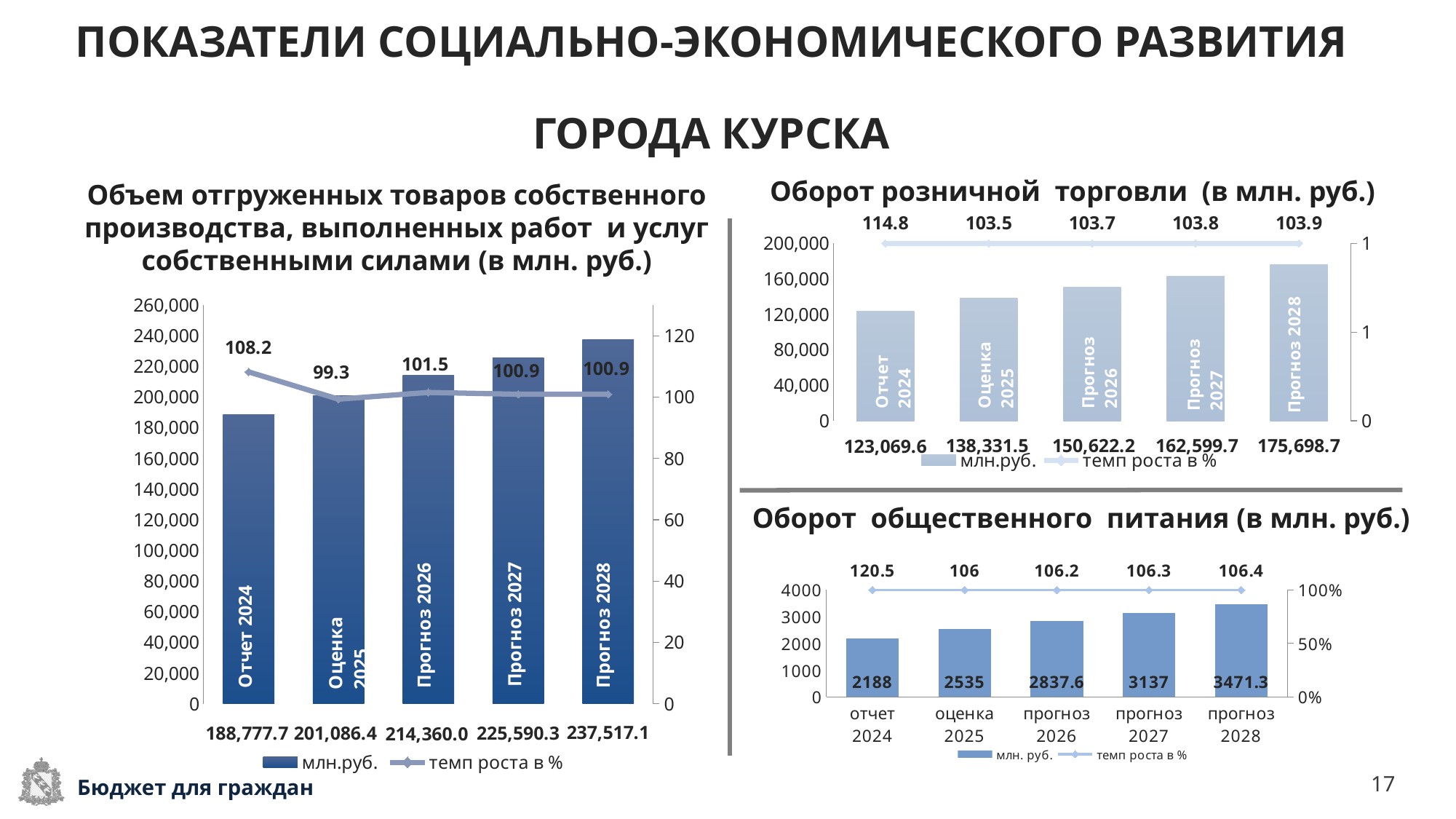
On the chart 'Оборот розничной торговли (в млн. руб.)', which period has the lowest growth rate (темп роста в %)? Оценка 2025 On the chart 'Оборот общественного питания (в млн. руб.)', do the bar values rise or fall from 'отчет 2024' to 'прогноз 2028'? rise On the chart 'Оборот розничной торговли (в млн. руб.)', what is the difference between the values for 'Прогноз 2028' and 'Отчет 2024'? 52,629.1 On the chart 'Оборот розничной торговли (в млн. руб.)', how many series does the legend list? 2 On the chart 'Оборот общественного питания (в млн. руб.)', what is the value for 'прогноз 2028'? 3471.3 On the chart 'Оборот розничной торговли (в млн. руб.)', what is the value for 'Отчет 2024'? 123,069.6 What type of chart is used for the 'Объем отгруженных товаров собственного производства...' chart? Bar chart with a line On the chart 'Объем отгруженных товаров собственного производства...', which period has the highest value in млн.руб.? Прогноз 2028 On the chart 'Объем отгруженных товаров собственного производства...', what is the growth rate (темп роста в %) for 'Оценка 2025'? 99.3 On the chart 'Объем отгруженных товаров собственного производства...', which is larger: the value for 'Прогноз 2026' or 'Оценка 2025'? Прогноз 2026 On the chart 'Оборот общественного питания (в млн. руб.)', how many periods are shown on the x axis? 5 On the chart 'Оборот общественного питания (в млн. руб.)', what is the difference between the values for 'прогноз 2028' and 'отчет 2024'? 1283.3